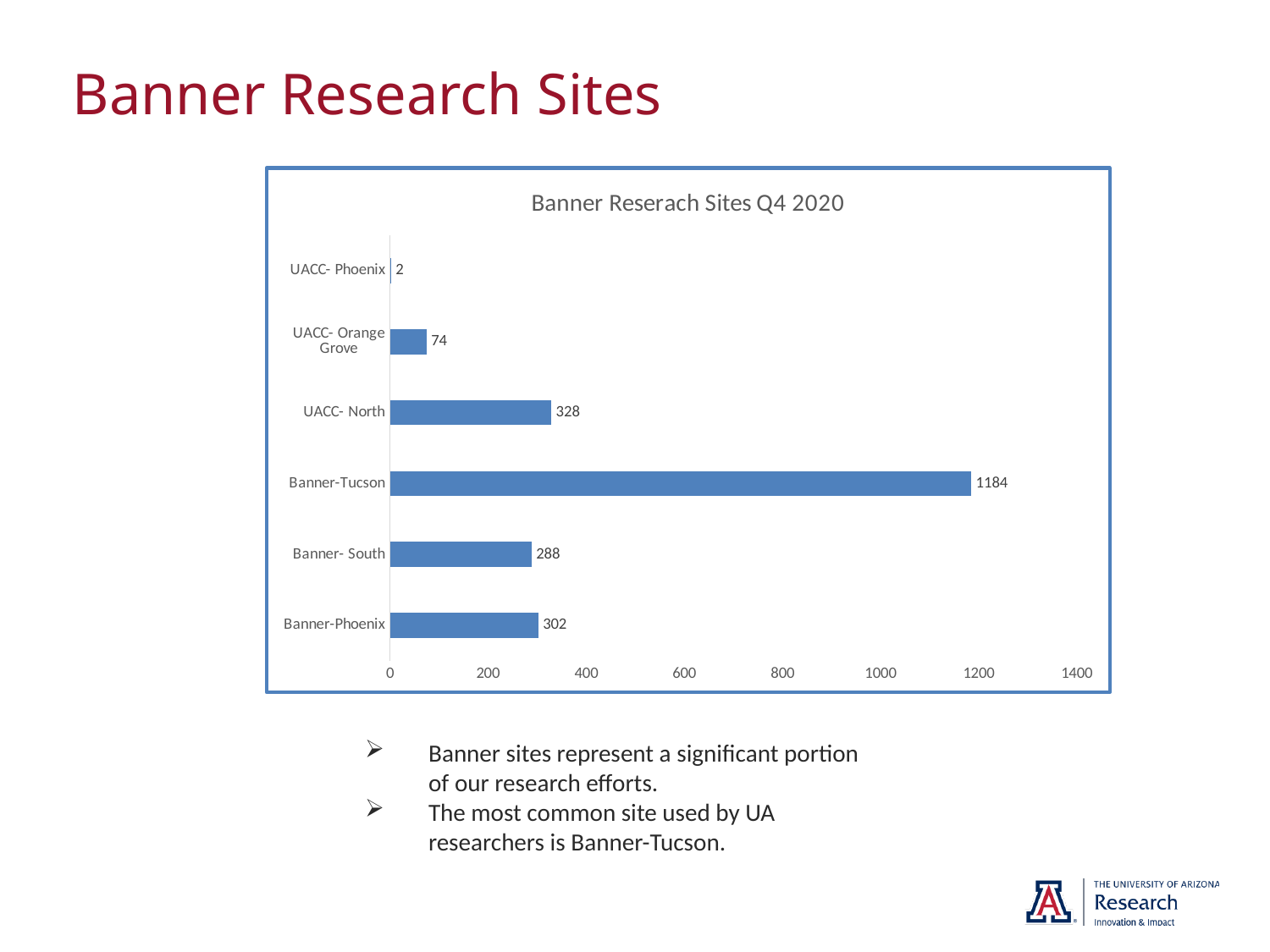
Which is larger, the value for UACC- North or the value for UACC- Orange Grove? UACC- North What is the value for Banner-Phoenix? 302 Which site has the lowest value? UACC- Phoenix What is the title of the chart? Banner Reserach Sites Q4 2020 What is the value for UACC- Orange Grove? 74 What is the difference between the values for Banner-Phoenix and Banner- South? 14 What kind of chart is shown on the slide? Bar chart How many sites are shown in the chart? 6 What is the difference between the values for Banner-Tucson and UACC- North? 856 What is the value for Banner-Tucson? 1184 Which site has the highest value? Banner-Tucson What is the value for UACC- Phoenix? 2